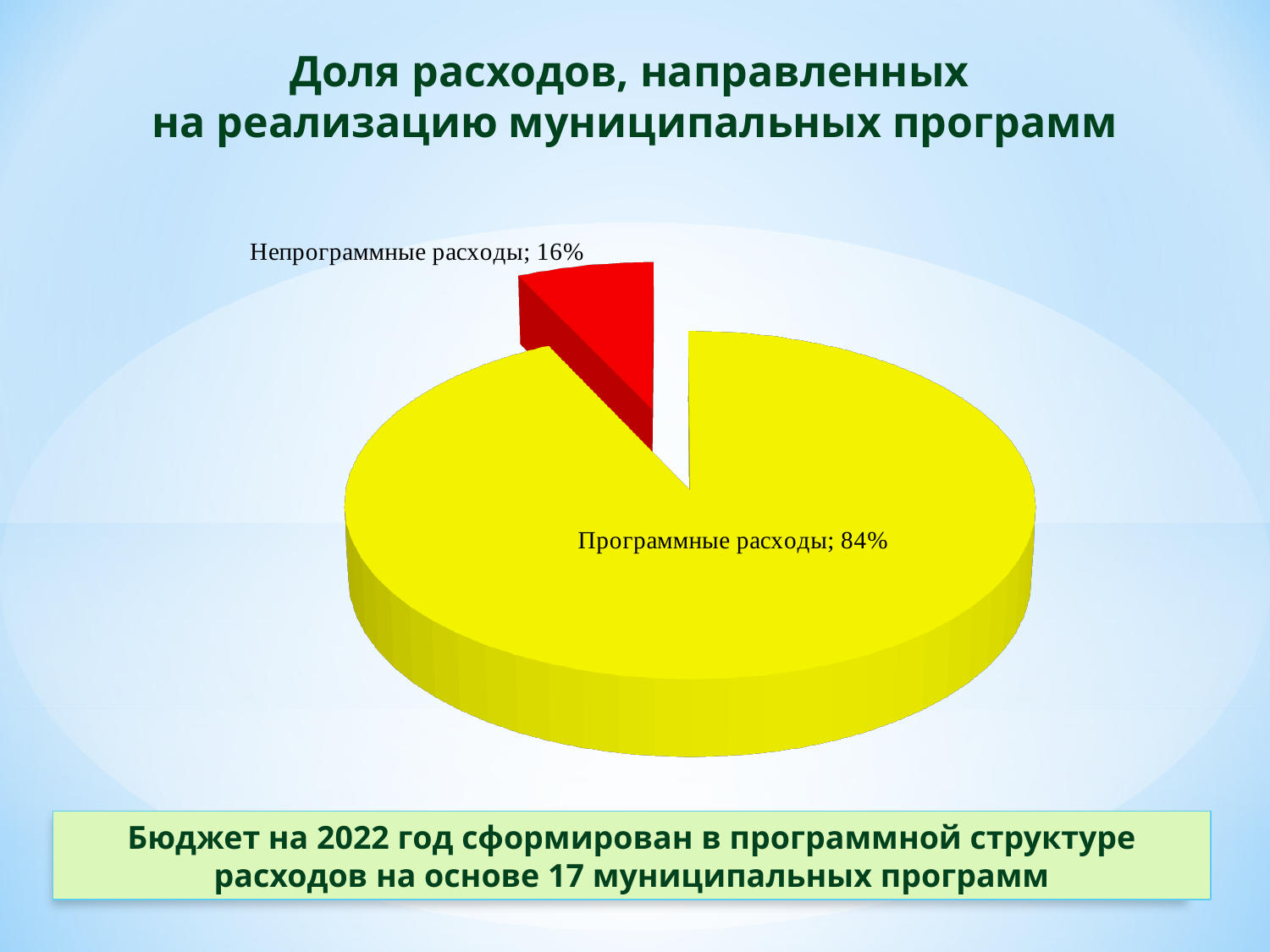
Which slice of the pie is the largest? Программные расходы What colour is the "Непрограммные расходы" slice? Red What kind of chart is shown on the slide? Pie chart What share of the pie is labelled "Программные расходы"? 84% Is the share for "Непрограммные расходы" greater or less than 50%? less How many slices does the pie chart have? 2 Which is larger: the "Программные расходы" slice or the "Непрограммные расходы" slice? Программные расходы What is the difference in percentage points between the "Программные расходы" and "Непрограммные расходы" slices? 68 What colour is the "Программные расходы" slice? Yellow Which slice of the pie is the smallest? Непрограммные расходы What share of the pie is labelled "Непрограммные расходы"? 16%